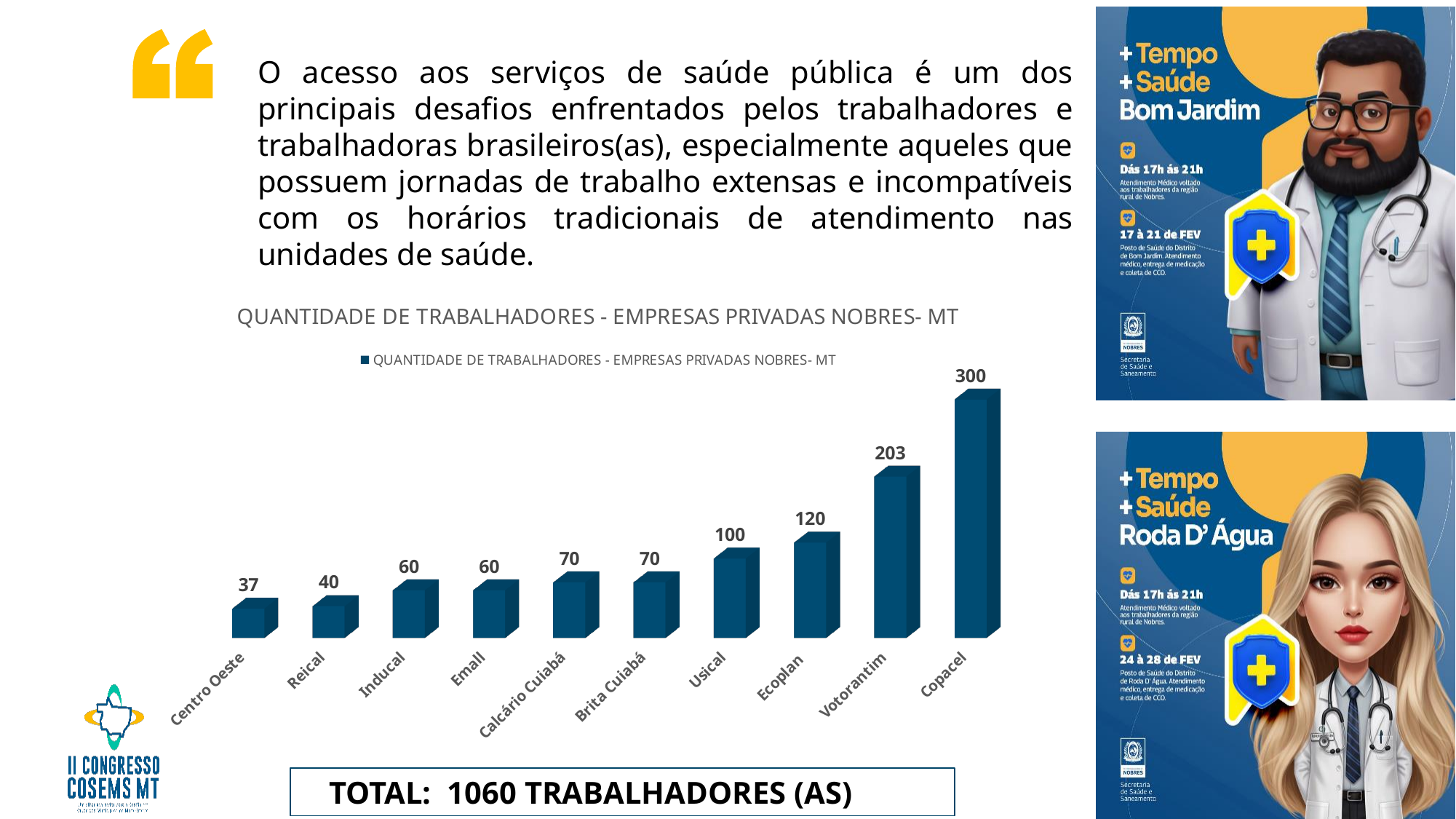
Which is larger, the value for Ecoplan or the value for Usical? Ecoplan What is the value for Votorantim? 203 What is the value for Centro Oeste? 37 What is the value for Copacel? 300 Do the values rise or fall from left to right along the x axis? Rise What is the difference between the values for Copacel and Votorantim? 97 What kind of chart is shown? Bar chart Which category has the highest value? Copacel How many categories are shown on the x axis? 10 Which category has the lowest value? Centro Oeste What is the title of the chart? QUANTIDADE DE TRABALHADORES - EMPRESAS PRIVADAS NOBRES- MT How many series does the legend list? 1